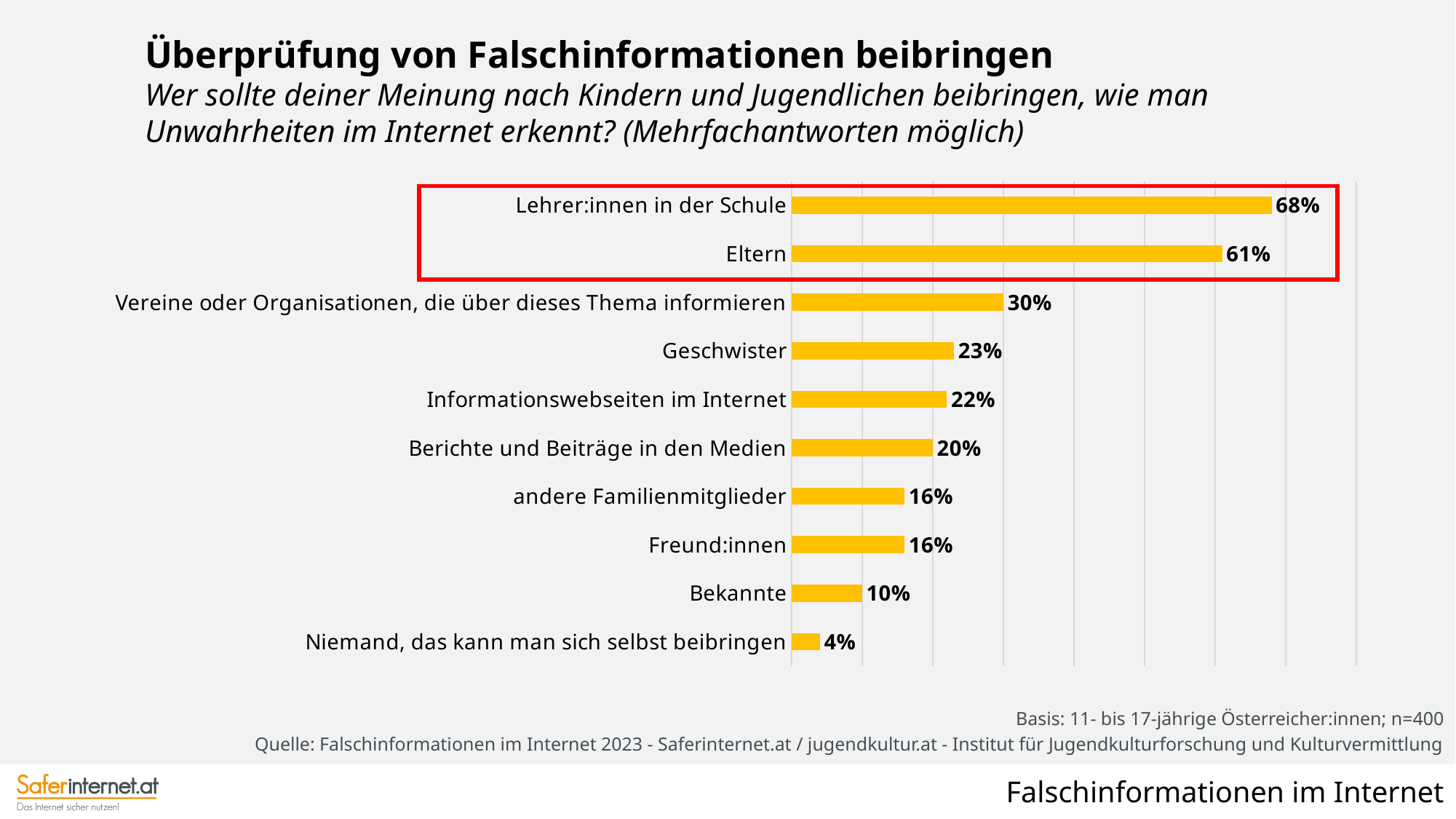
What percentage is shown for "Geschwister"? 23% What is the value for "Niemand, das kann man sich selbst beibringen"? 4% What percentage of respondents chose "Lehrer:innen in der Schule"? 68% What is the difference between the values for "Lehrer:innen in der Schule" and "Eltern"? 7% Which category has the lowest value? Niemand, das kann man sich selbst beibringen What is the value shown for "Eltern"? 61% Which is larger: the value for "Informationswebseiten im Internet" or for "Berichte und Beiträge in den Medien"? Informationswebseiten im Internet What kind of chart is shown on the slide? Bar chart How many categories are shown in the chart? 10 Which two categories are highlighted with a red box? Lehrer:innen in der Schule and Eltern Which category has the highest value? Lehrer:innen in der Schule What is the difference between "Vereine oder Organisationen, die über dieses Thema informieren" and "Bekannte"? 20%